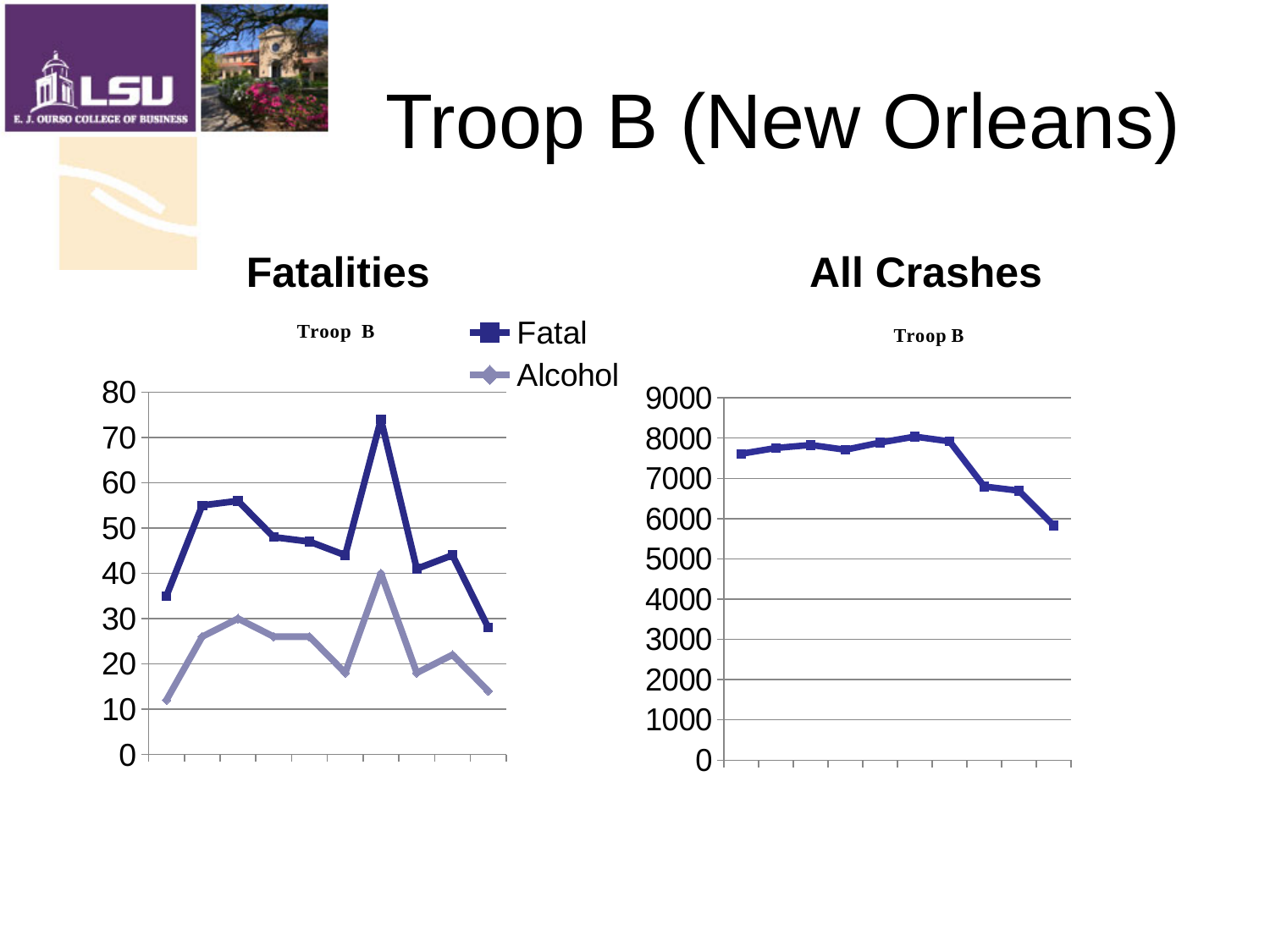
What kind of chart is the Fatalities chart on the left? Line chart What kind of chart is the All Crashes chart on the right? Line chart In the All Crashes chart, do the values overall rise or fall from the first point to the last point? fall In the All Crashes chart, is the last value greater or less than 6000? less How many series does the legend of the Fatalities chart list? 2 What are the two series named in the legend of the Fatalities chart? Fatal and Alcohol How many data points are plotted in the All Crashes chart? 10 How many data points does the Fatal series have in the Fatalities chart? 10 In the Fatalities chart, is the highest value of the Alcohol series greater or less than 30? greater In the Fatalities chart, which series has the higher peak value, Fatal or Alcohol? Fatal In the Fatalities chart, is the first value of the Alcohol series greater or less than 20? less